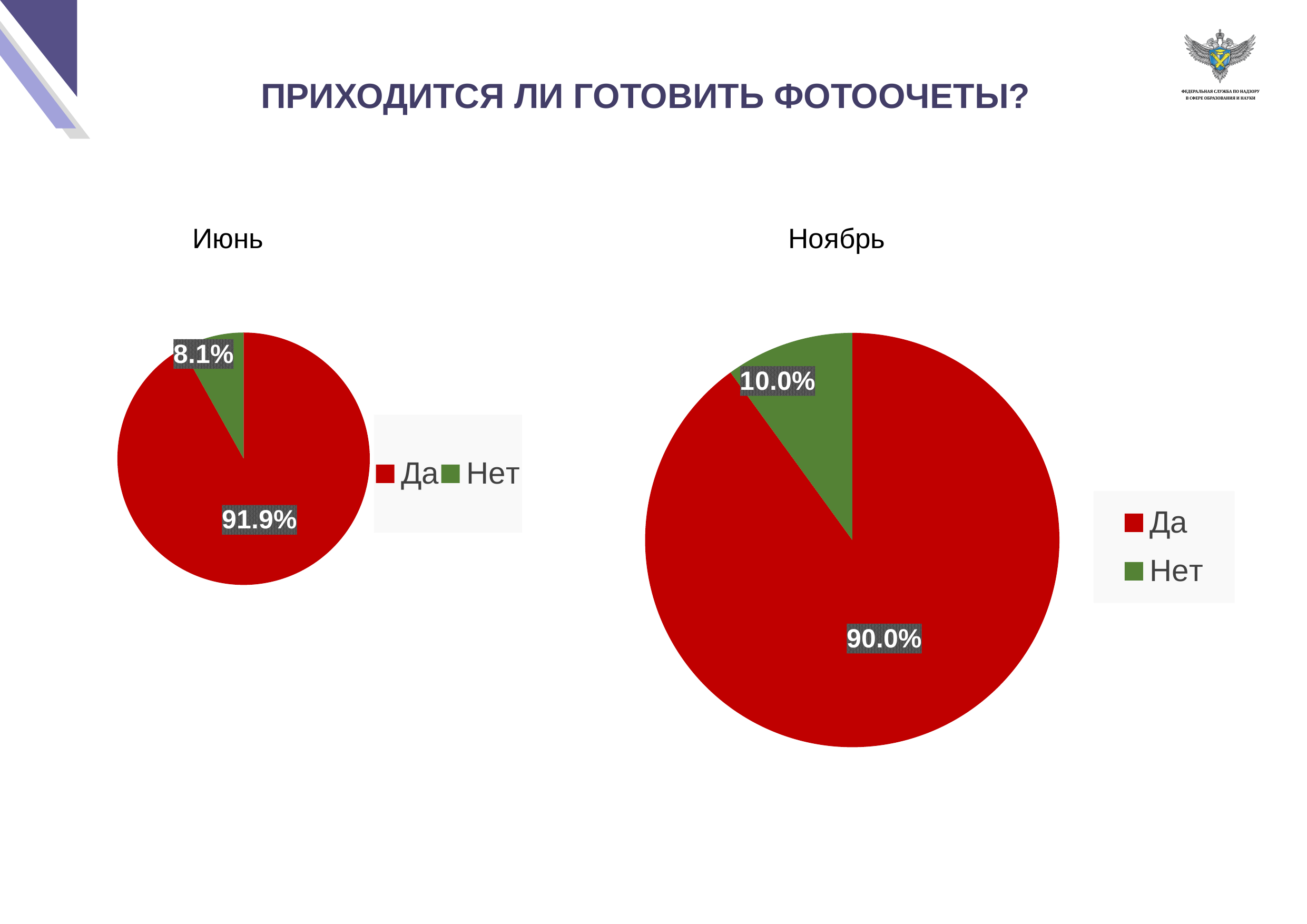
How many slices does the Июнь chart have? 2 In the Ноябрь chart, what is the value for Да? 90.0% In the Июнь chart, what is the value for Да? 91.9% Which is larger: the Нет slice in the Июнь chart or the Нет slice in the Ноябрь chart? Ноябрь What kind of chart is the Ноябрь chart? Pie chart In the Июнь chart, what is the value for Нет? 8.1% In the Июнь chart, which slice is the largest? Да In the Ноябрь chart, what colour is the Да slice? Red In the Ноябрь chart, what is the value for Нет? 10.0% In the Ноябрь chart, what is the difference between the Да and Нет slices? 80.0% In the Июнь chart, what is the difference between the Да and Нет slices? 83.8% In the Ноябрь chart, which slice is the smallest? Нет